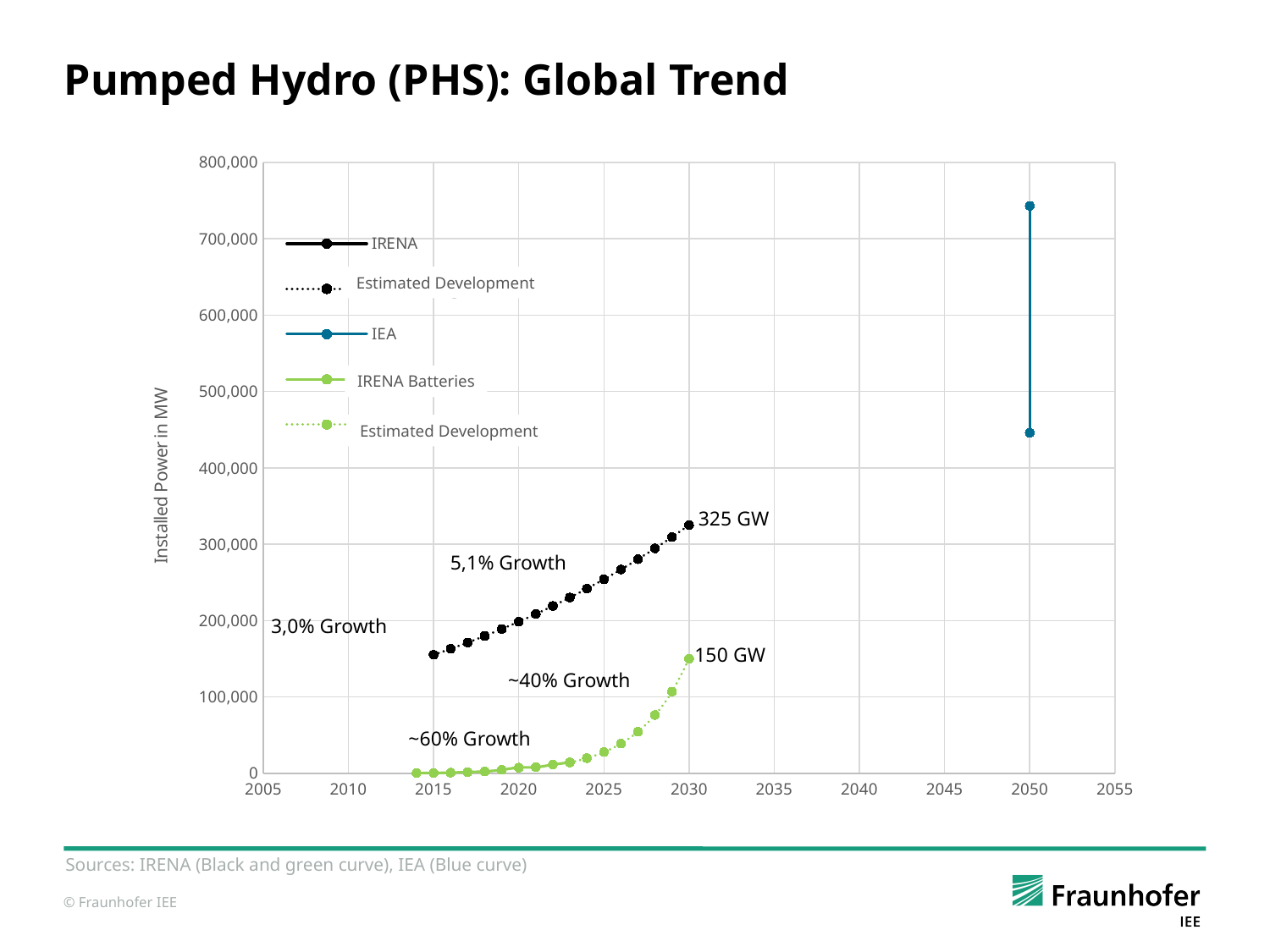
Does the black IRENA line rise or fall from 2014 to 2030? rise Is the IRENA value in 2015 greater or less than 200,000 MW? less How many series does the chart legend list? 5 In 2030, which is larger: the labelled value of the black IRENA line or the green IRENA Batteries line? the black IRENA line (325 GW) What growth rate is annotated next to the black dotted estimated development line? 5,1% Growth What value is labelled at the 2030 end of the green IRENA Batteries estimated development line? 150 GW What value is labelled at the 2030 end of the black IRENA estimated development line? 325 GW What is the y-axis title of the chart? Installed Power in MW What type of chart is shown on the slide? line chart What is the difference between the 2030 labelled values of the black line (325 GW) and the green line (150 GW)? 175 GW Is the lower IEA point at 2050 greater or less than 500,000 MW? less Is the upper IEA point at 2050 greater or less than 700,000 MW? greater